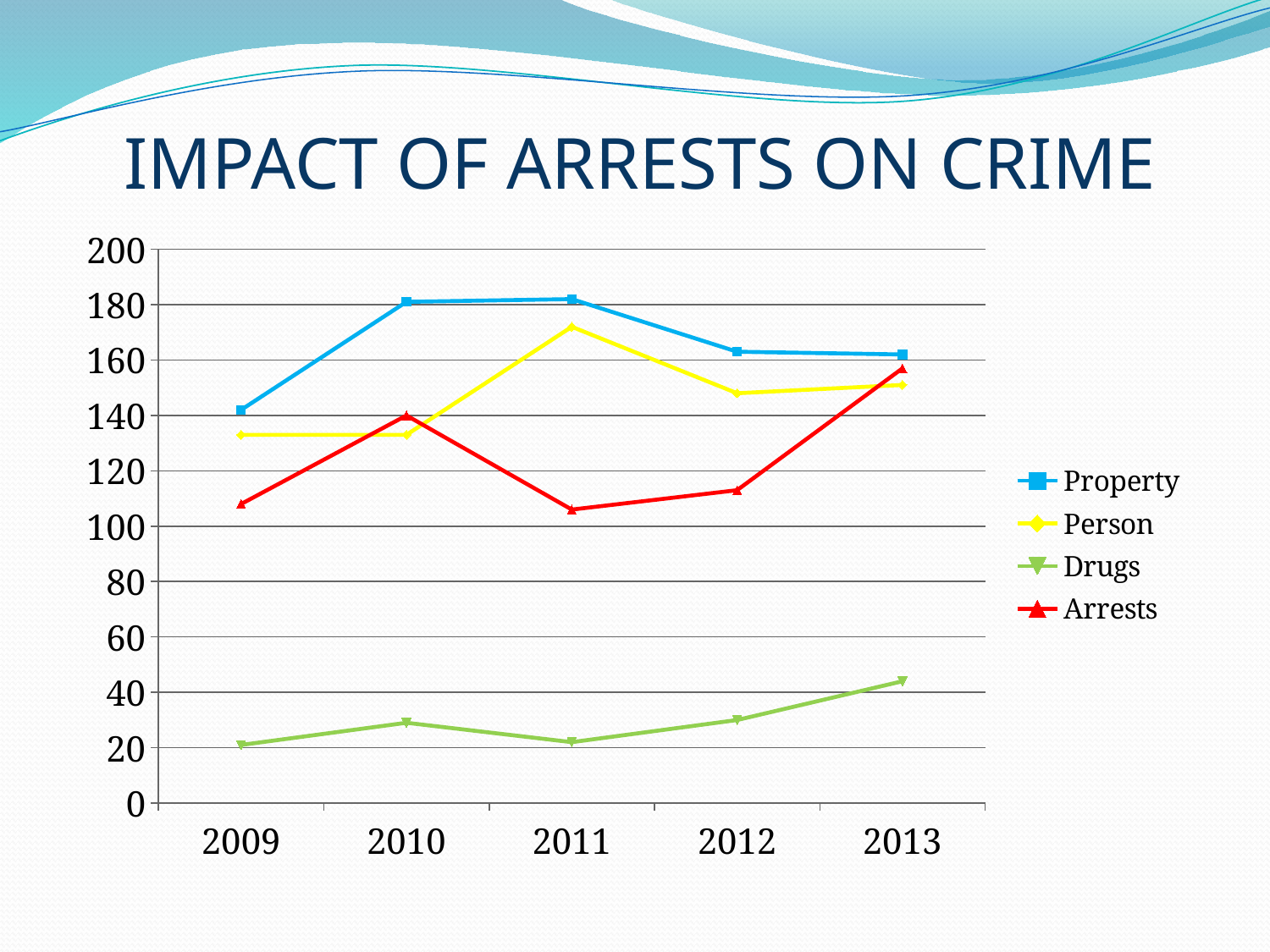
How many years are shown on the x axis? 5 Does the Drugs series rise or fall from 2012 to 2013? rise How many series does the legend list? 4 Is the value for Arrests in 2011 greater or less than 120? less Which series is drawn in red? Arrests In which year is the Person series highest? 2011 In which year is the Drugs series highest? 2013 In which year is the Property series lowest? 2009 Is the value for Property in 2010 greater or less than 160? greater What is the title of the slide? IMPACT OF ARRESTS ON CRIME What kind of chart is shown on the slide? line chart Which is larger in 2010, Property or Person? Property